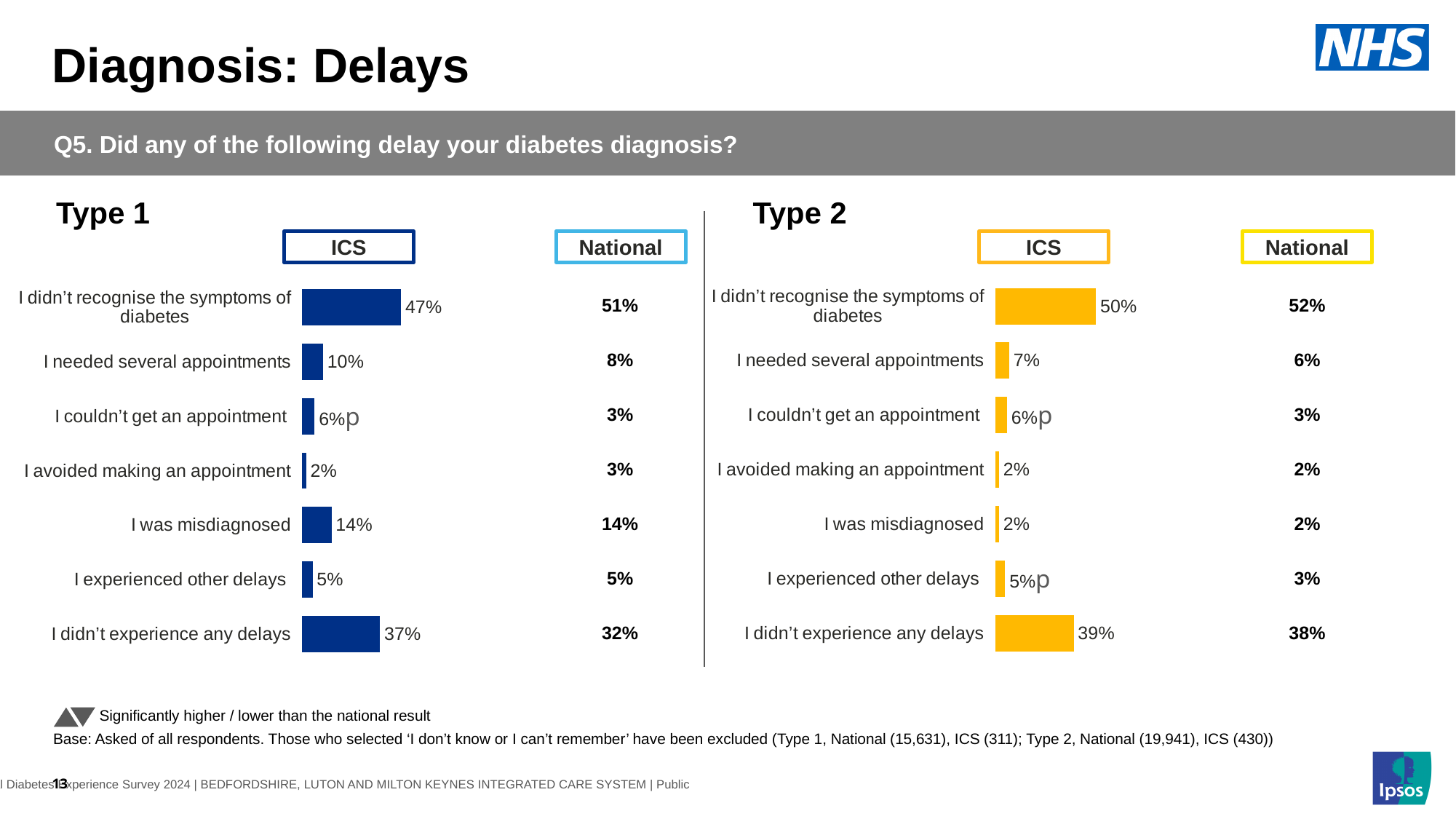
In the Type 1 chart, what is the ICS value for 'I didn't recognise the symptoms of diabetes'? 47% What type of chart is used to show the ICS values in the Type 1 chart? Bar chart In the Type 2 chart, which is larger for 'I was misdiagnosed': the ICS value for Type 2 or the ICS value for 'I was misdiagnosed' in the Type 1 chart? Type 1 In the Type 1 chart, which category has the highest ICS value? I didn't recognise the symptoms of diabetes In the Type 1 chart, what is the National value for 'I didn't experience any delays'? 32% In the Type 1 chart, which is larger for 'I didn't experience any delays': the ICS value or the National value? ICS In the Type 1 chart, what is the difference between the ICS values for 'I was misdiagnosed' and 'I needed several appointments'? 4 percentage points How many categories are shown in the Type 2 chart? 7 In the Type 2 chart, what is the National value for 'I needed several appointments'? 6% In the Type 2 chart, what is the difference between the ICS and National values for 'I didn't recognise the symptoms of diabetes'? 2 percentage points In the Type 1 chart, which category has the lowest ICS value? I avoided making an appointment In the Type 2 chart, what is the ICS value for 'I didn't experience any delays'? 39%